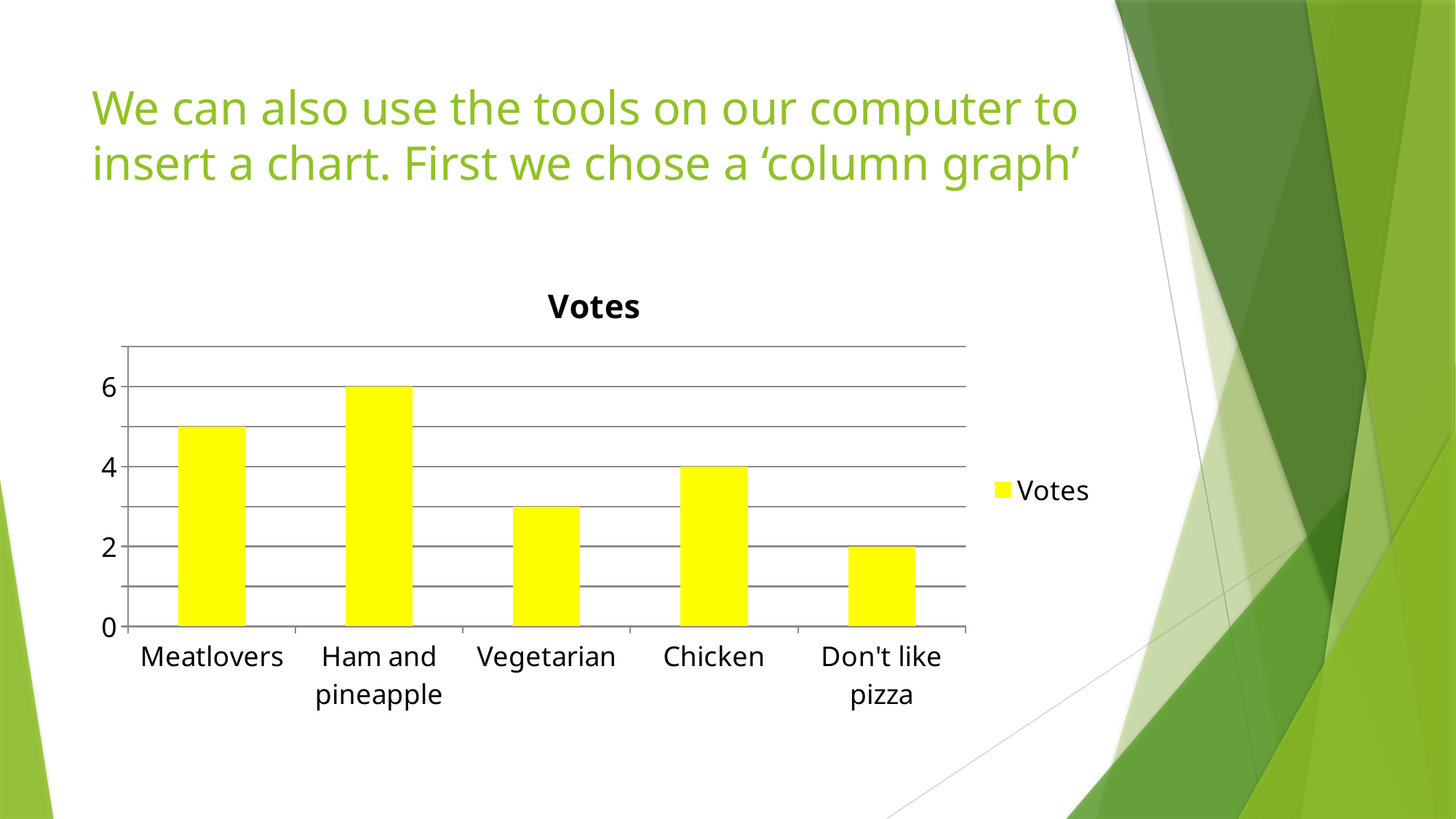
What is the difference between the values for Chicken and Don't like pizza? 2 Is the value for Vegetarian greater or less than 4? less What kind of chart is shown on the slide? bar chart How many categories are shown on the x axis? 5 What is the value for Don't like pizza? 2 What is the value for Ham and pineapple? 6 Which category has the highest number of votes? Ham and pineapple What is the value for Chicken? 4 What is the difference between the values for Ham and pineapple and Chicken? 2 Is the value for Meatlovers greater or less than 4? greater Which category has the lowest number of votes? Don't like pizza Which is larger, the value for Meatlovers or the value for Vegetarian? Meatlovers